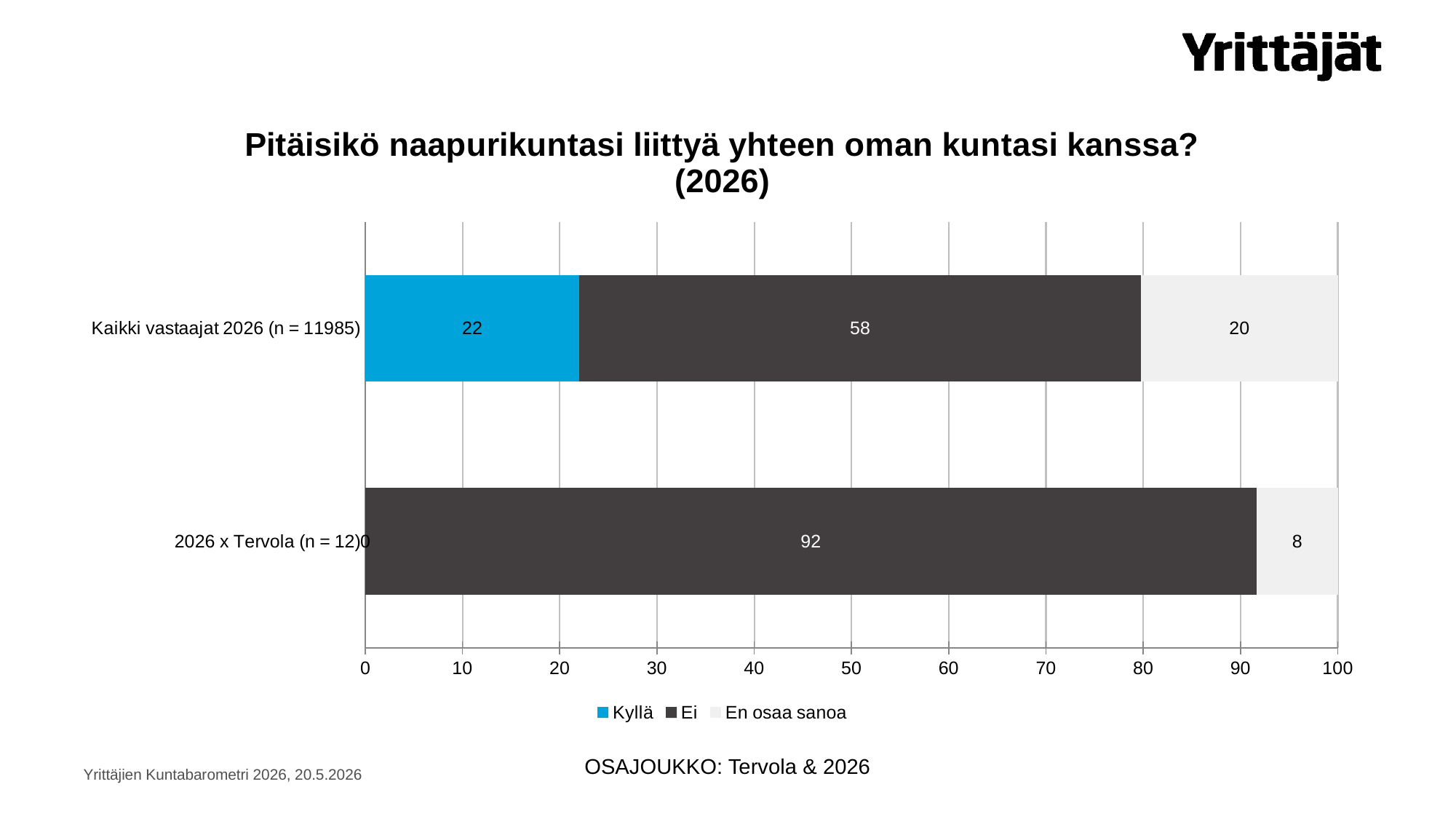
What is the value for En osaa sanoa for 2026 x Tervola (n = 12)? 8 How many categories are shown on the chart? 2 What is the value for Kyllä for Kaikki vastaajat 2026 (n = 11985)? 22 What is the value for Kyllä for 2026 x Tervola (n = 12)? 0 What is the value for Ei for 2026 x Tervola (n = 12)? 92 What is the value for Ei for Kaikki vastaajat 2026 (n = 11985)? 58 How many series does the legend list? 3 What is the total of the stacked bar for Kaikki vastaajat 2026 (n = 11985)? 100 What kind of chart is shown on the slide? Stacked bar chart What is the difference between the Ei values for 2026 x Tervola (n = 12) and Kaikki vastaajat 2026 (n = 11985)? 34 Is the En osaa sanoa value larger for Kaikki vastaajat 2026 (n = 11985) or for 2026 x Tervola (n = 12)? Kaikki vastaajat 2026 (n = 11985) Which category has the higher Ei value? 2026 x Tervola (n = 12)